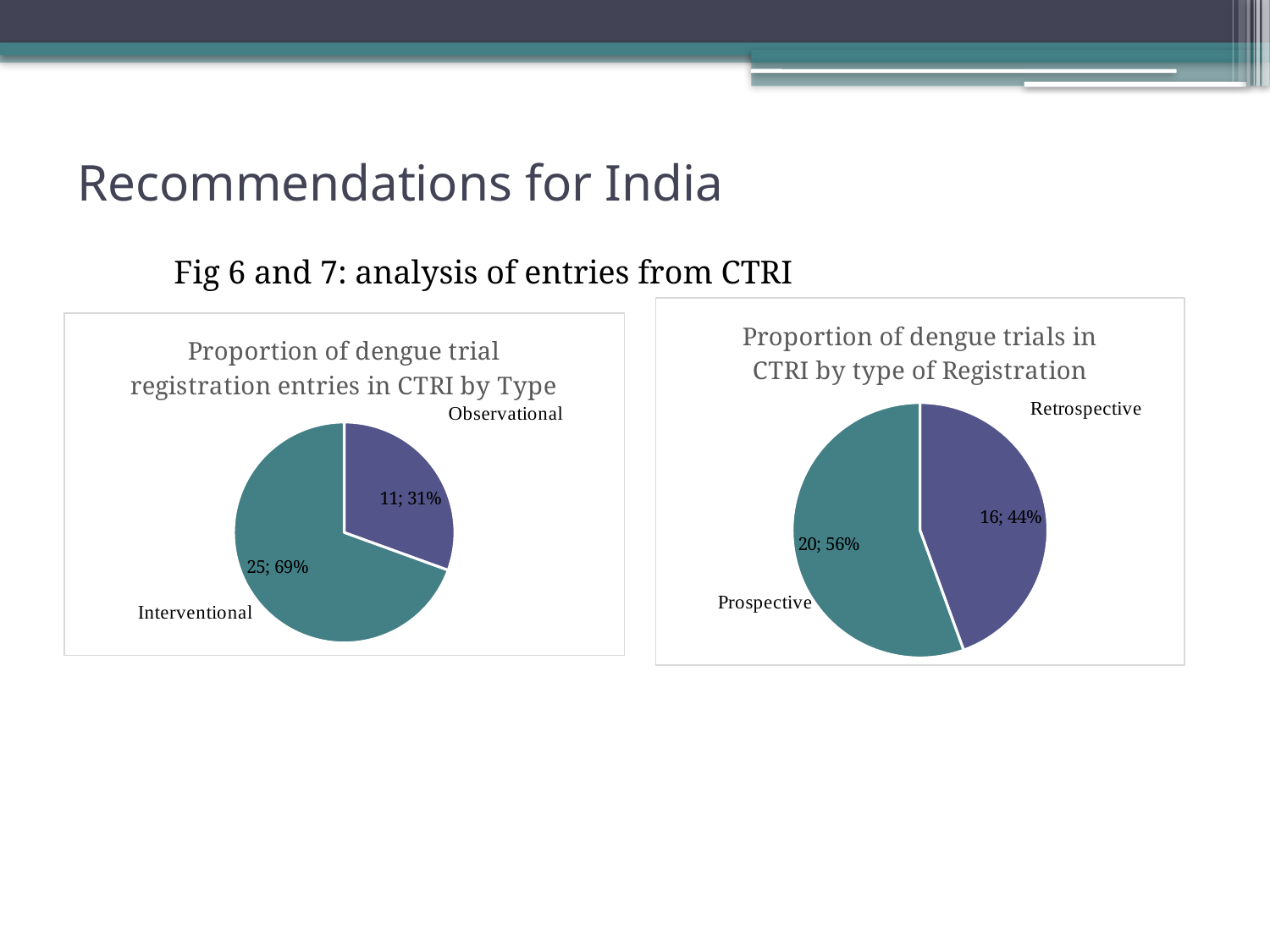
In the right chart, 'Proportion of dengue trials in CTRI by type of Registration', what is the total number of trials across both slices? 36 In the right chart, 'Proportion of dengue trials in CTRI by type of Registration', which is larger: Prospective or Retrospective? Prospective In the left chart, 'Proportion of dengue trial registration entries in CTRI by Type', which category has the largest slice? Interventional In the right chart, 'Proportion of dengue trials in CTRI by type of Registration', which category has the smaller slice? Retrospective In the left chart, 'Proportion of dengue trial registration entries in CTRI by Type', how many slices does the pie have? 2 In the left chart, 'Proportion of dengue trial registration entries in CTRI by Type', what is the difference between the Interventional and Observational counts? 14 In the left chart, 'Proportion of dengue trial registration entries in CTRI by Type', what percentage of entries are Observational? 31% What kind of chart is the right chart, 'Proportion of dengue trials in CTRI by type of Registration'? Pie chart In the left chart, 'Proportion of dengue trial registration entries in CTRI by Type', how many entries are Interventional? 25 In the right chart, 'Proportion of dengue trials in CTRI by type of Registration', how many trials are Retrospective? 16 In the left chart, 'Proportion of dengue trial registration entries in CTRI by Type', what colour is the Observational slice? Purple In the right chart, 'Proportion of dengue trials in CTRI by type of Registration', what percentage of trials are Prospective? 56%